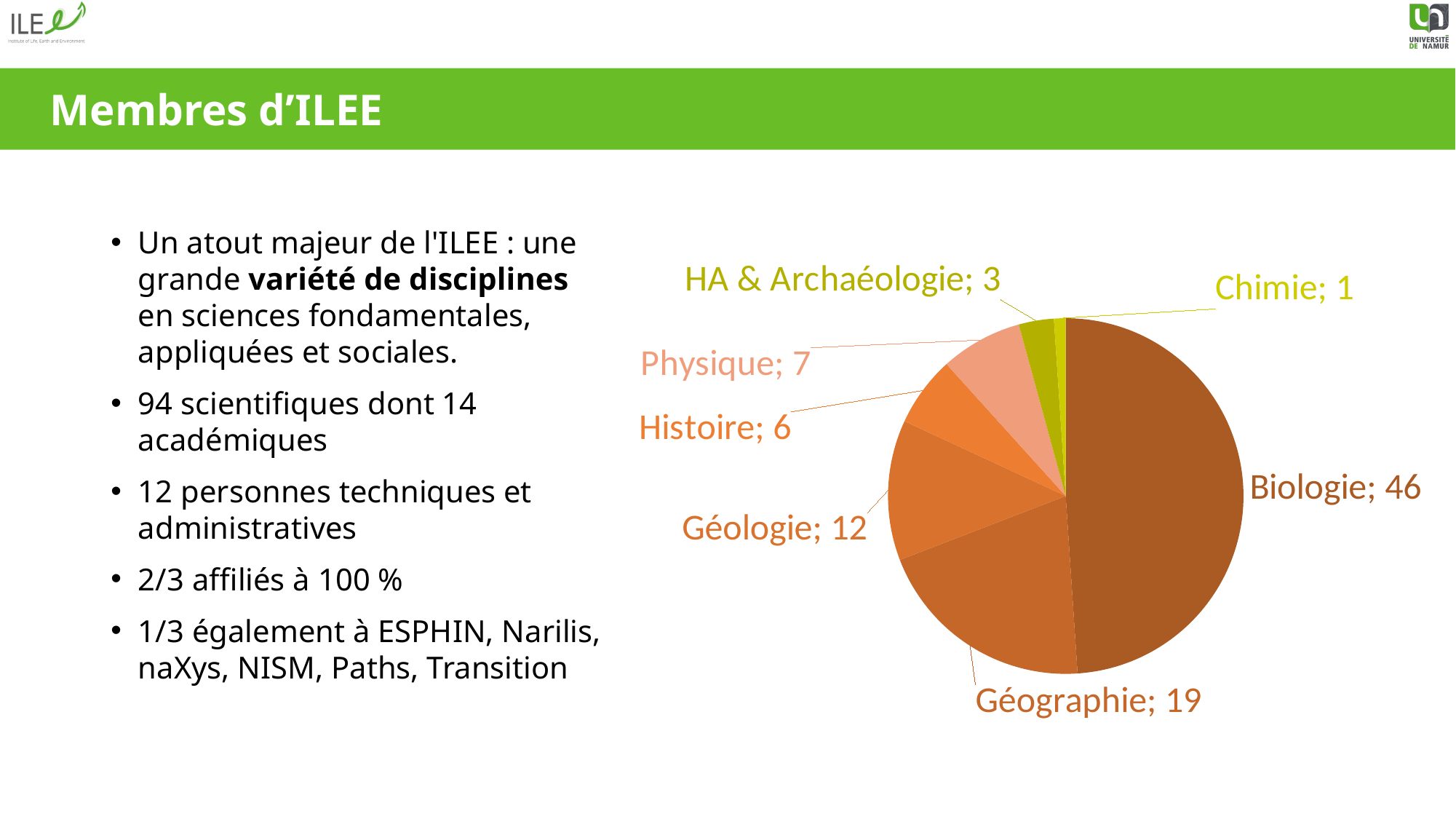
What is the value shown for HA & Archaéologie? 3 How many disciplines (slices) are shown in the pie chart? 7 Which discipline has the smallest slice of the pie? Chimie What is the difference between the values for Biologie and Géographie? 27 Which is larger, the value for Physique or the value for Histoire? Physique What is the value shown for Géographie? 19 What is the difference between the values for Géologie and Histoire? 6 How many members does the Biologie slice represent? 46 What is the total of all the slice values in the pie chart? 94 What type of chart is shown on the slide? pie chart Which discipline has the largest slice of the pie? Biologie What is the value shown for Physique? 7